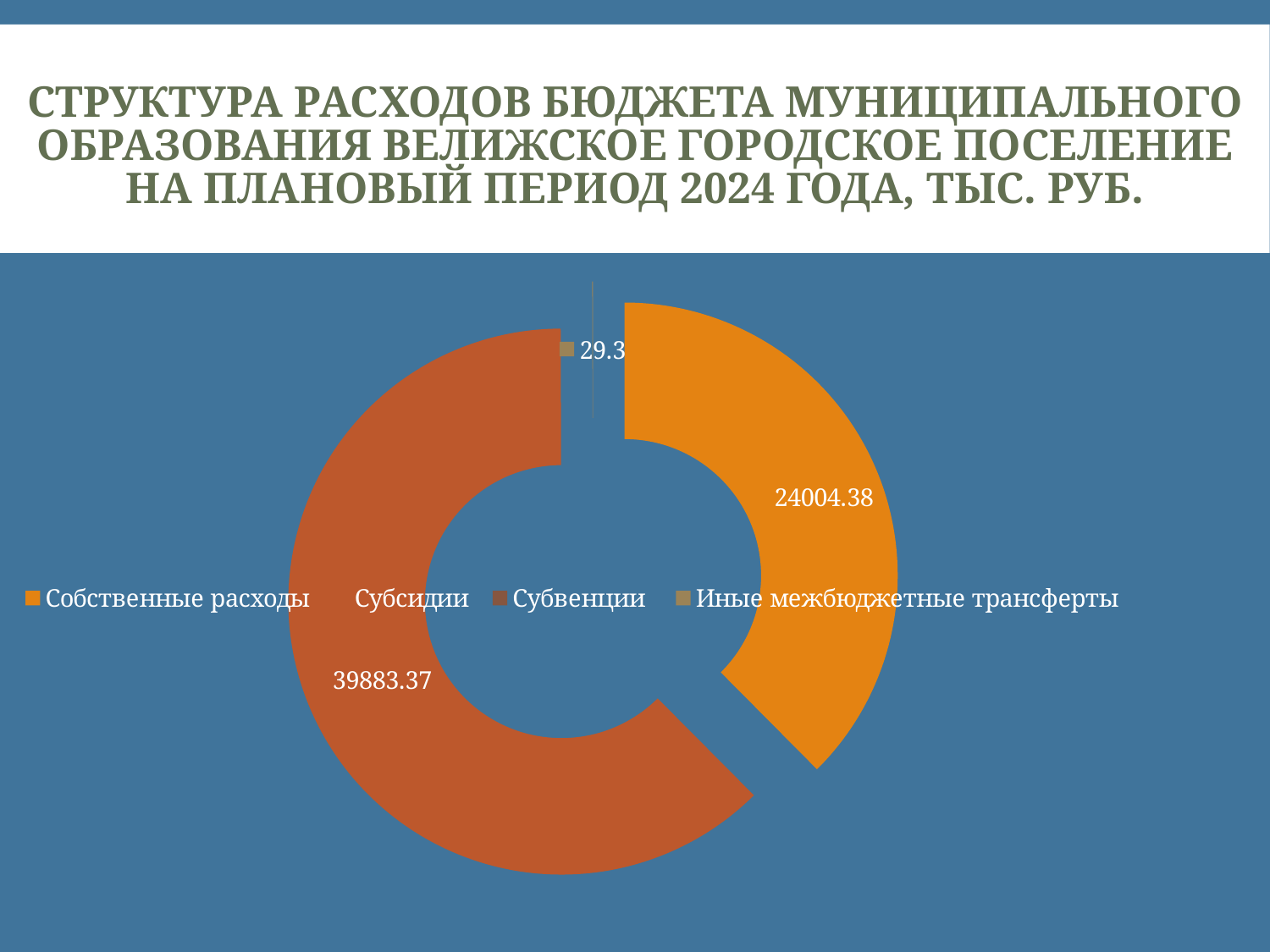
What is the difference between Собственные расходы and Иные межбюджетные трансферты? 23975.08 What is the value for Иные межбюджетные трансферты? 29.3 Which category has the largest value? Субсидии What colour is the slice for Собственные расходы? orange What kind of chart is shown on the slide? doughnut chart Which is larger, Собственные расходы or Иные межбюджетные трансферты? Собственные расходы What unit is stated in the slide title for the values? тыс. руб. What is the value for Собственные расходы? 24004.38 How many entries does the legend list? 4